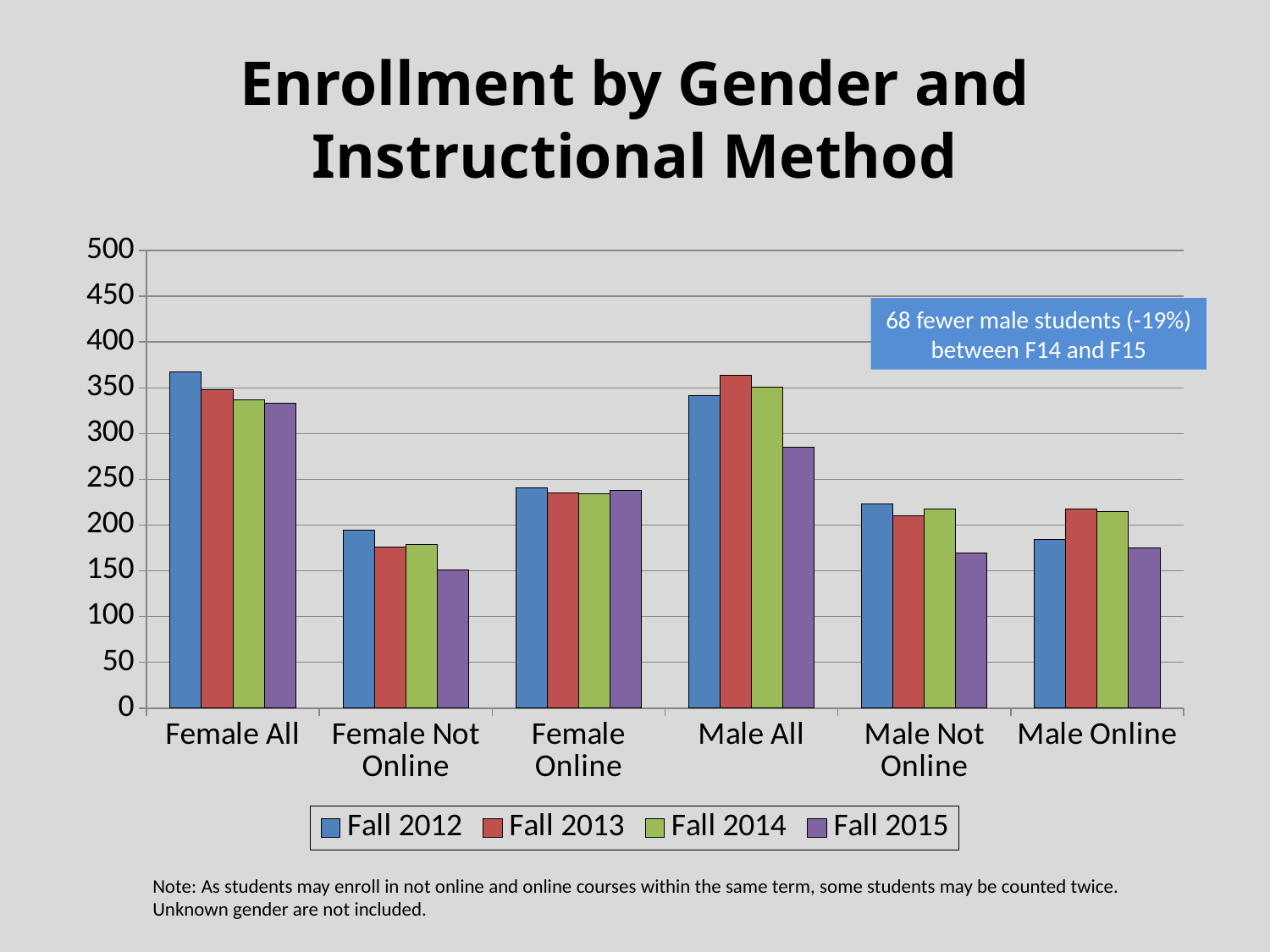
What kind of chart is shown on the slide? Bar chart What does the callout box on the chart say? 68 fewer male students (-19%) between F14 and F15 Which category has the highest Fall 2012 bar? Female All Is the Fall 2015 value for Male All greater or less than 300? less For Male All, which is larger: the Fall 2013 value or the Fall 2015 value? Fall 2013 Which category has the lowest Fall 2015 bar? Female Not Online How many categories are shown on the x axis? 6 Do the Female All values rise or fall from Fall 2012 to Fall 2015? Fall Is the Fall 2015 value for Male Not Online greater or less than 200? less Is the Fall 2012 value for Female All greater or less than 350? greater How many series does the legend list? 4 For Fall 2012, which is larger: Female Online or Female Not Online? Female Online